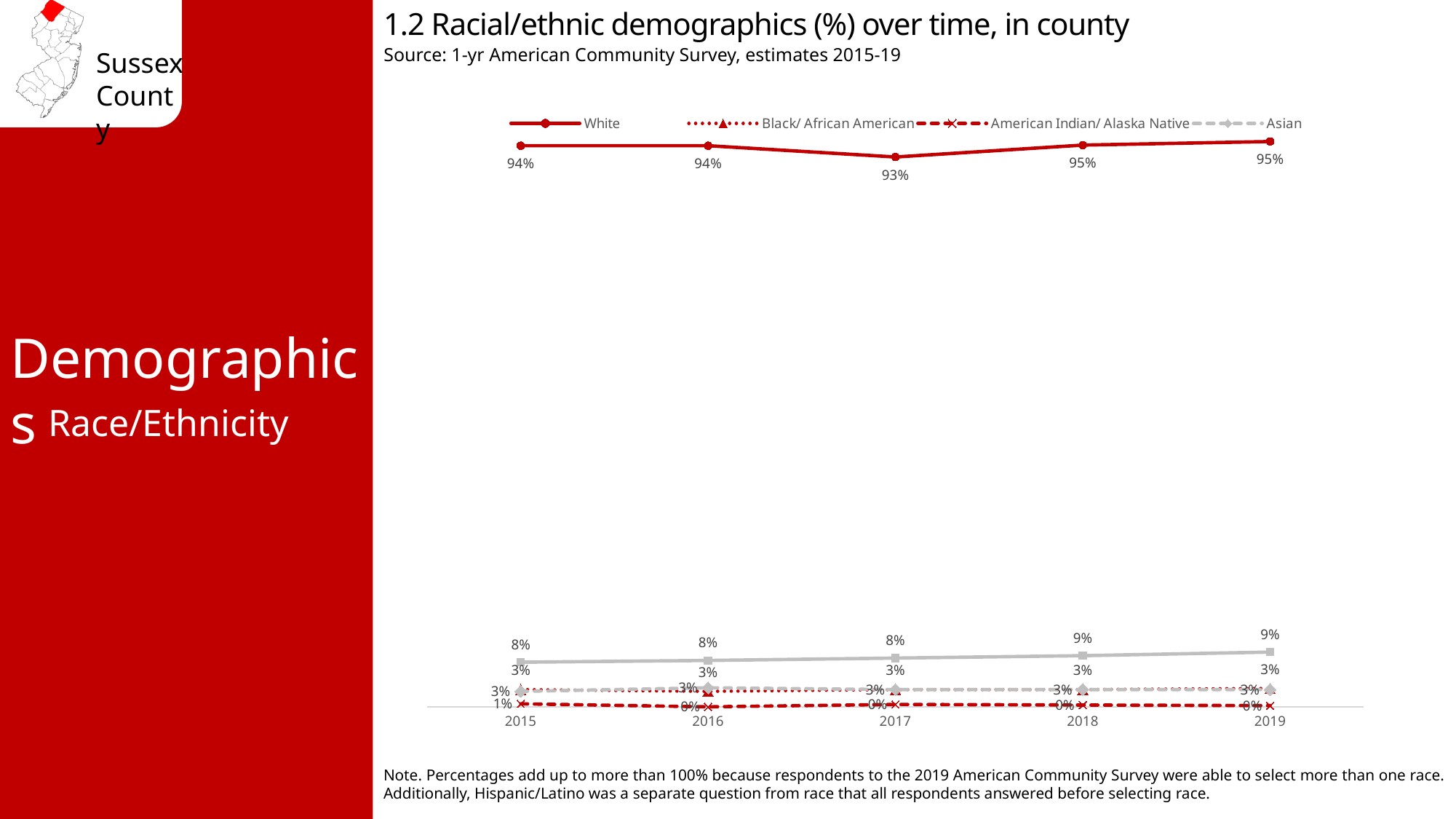
What is the value for American Indian/ Alaska Native in 2015? 1% What is the value for White in 2019? 95% What is the value for White in 2017? 93% Which is larger, the White value in 2015 or in 2017? 2015 How many years are shown on the x axis? 5 In which year is the White percentage lowest? 2017 What is the difference between the White value in 2019 and in 2017? 2% What is the title of the chart? 1.2 Racial/ethnic demographics (%) over time, in county What is the value for White in 2015? 94% What is the value for American Indian/ Alaska Native in 2019? 0% What kind of chart is shown on the slide? Line chart Does the White percentage rise or fall from 2017 to 2019? Rise